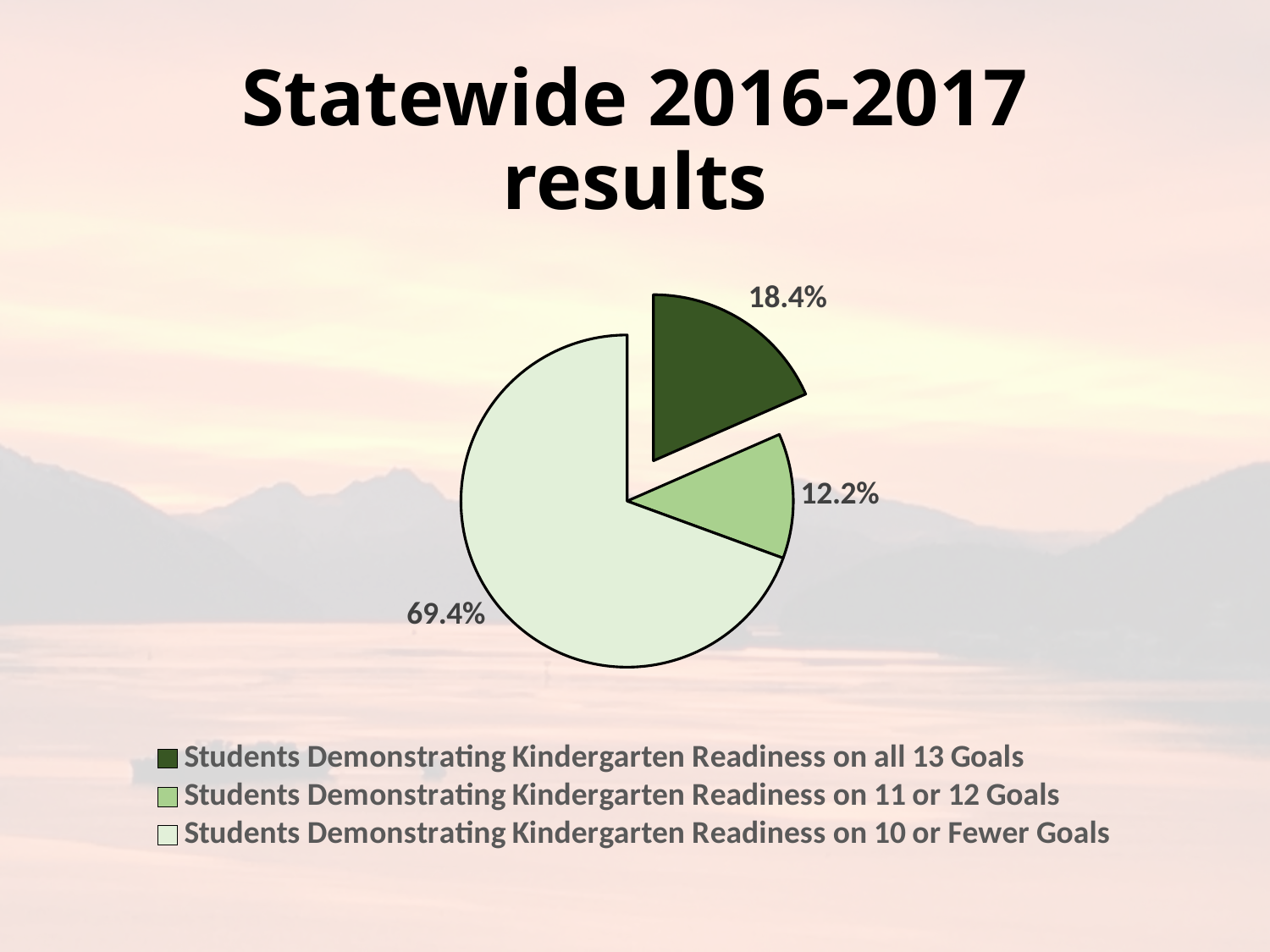
What percentage of students demonstrated kindergarten readiness on 11 or 12 goals? 12.2% What percentage of students demonstrated kindergarten readiness on all 13 goals? 18.4% What kind of chart is shown on the slide? pie chart Which category has the smallest slice of the pie? Students Demonstrating Kindergarten Readiness on 11 or 12 Goals What is the difference in percentage points between the 'all 13 Goals' slice and the '11 or 12 Goals' slice? 6.2 What is the title of the slide containing the pie chart? Statewide 2016-2017 results How many entries does the legend list? 3 How many slices does the pie chart have? 3 What is the difference in percentage points between the '10 or Fewer Goals' slice and the 'all 13 Goals' slice? 51.0 Which is larger: the share of students ready on all 13 goals or the share ready on 11 or 12 goals? all 13 Goals Which category has the largest slice of the pie? Students Demonstrating Kindergarten Readiness on 10 or Fewer Goals What percentage of students demonstrated kindergarten readiness on 10 or fewer goals? 69.4%